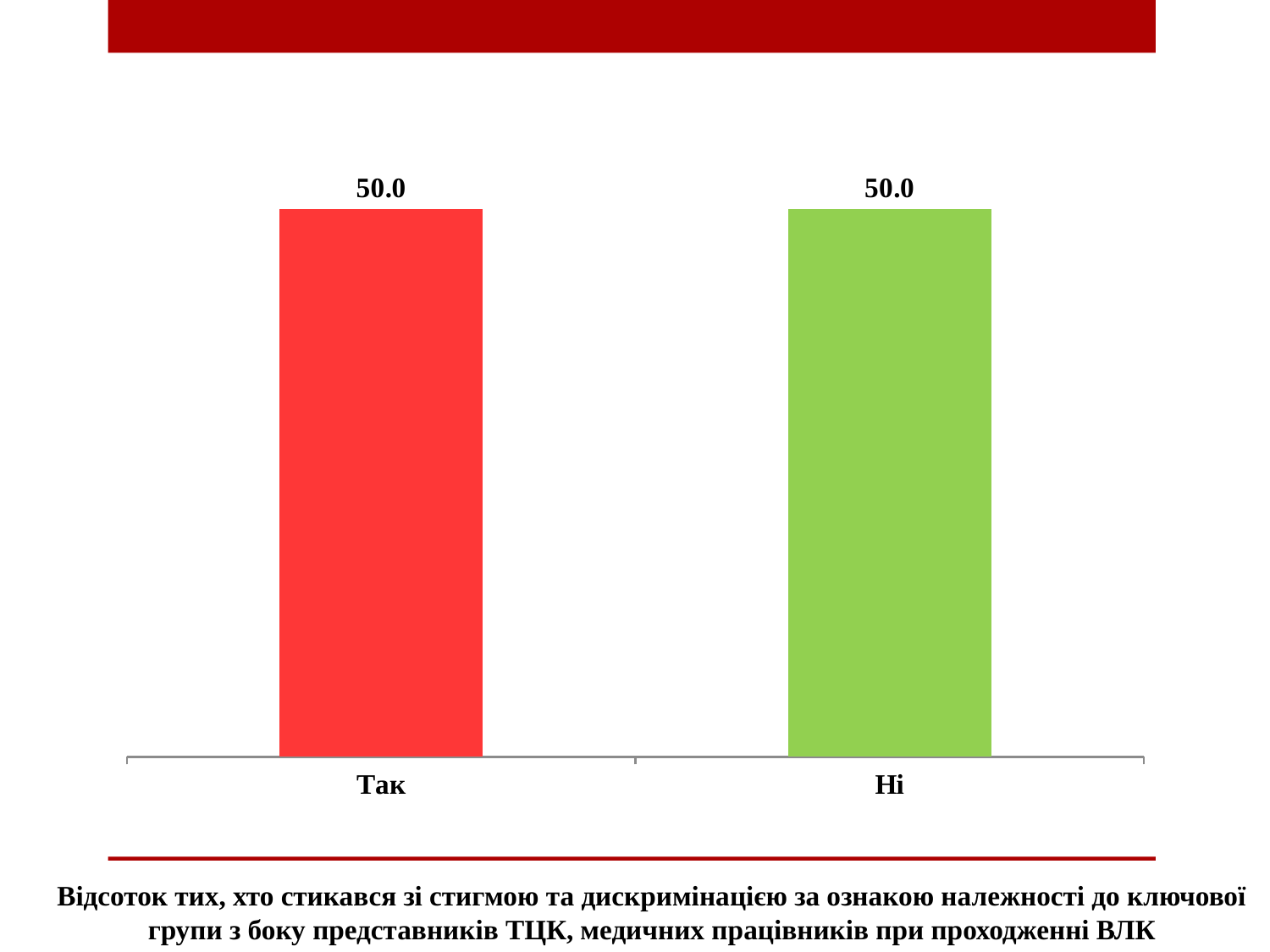
What colour is the bar for Ні? green What colour is the bar for Так? red Are the values for Так and Ні equal? yes What is the value for Ні? 50.0 How many categories are shown on the x axis? 2 What is the difference between the values for Так and Ні? 0.0 What is the value for Так? 50.0 What kind of chart is shown on the slide? bar chart What is the total of the values for Так and Ні? 100.0